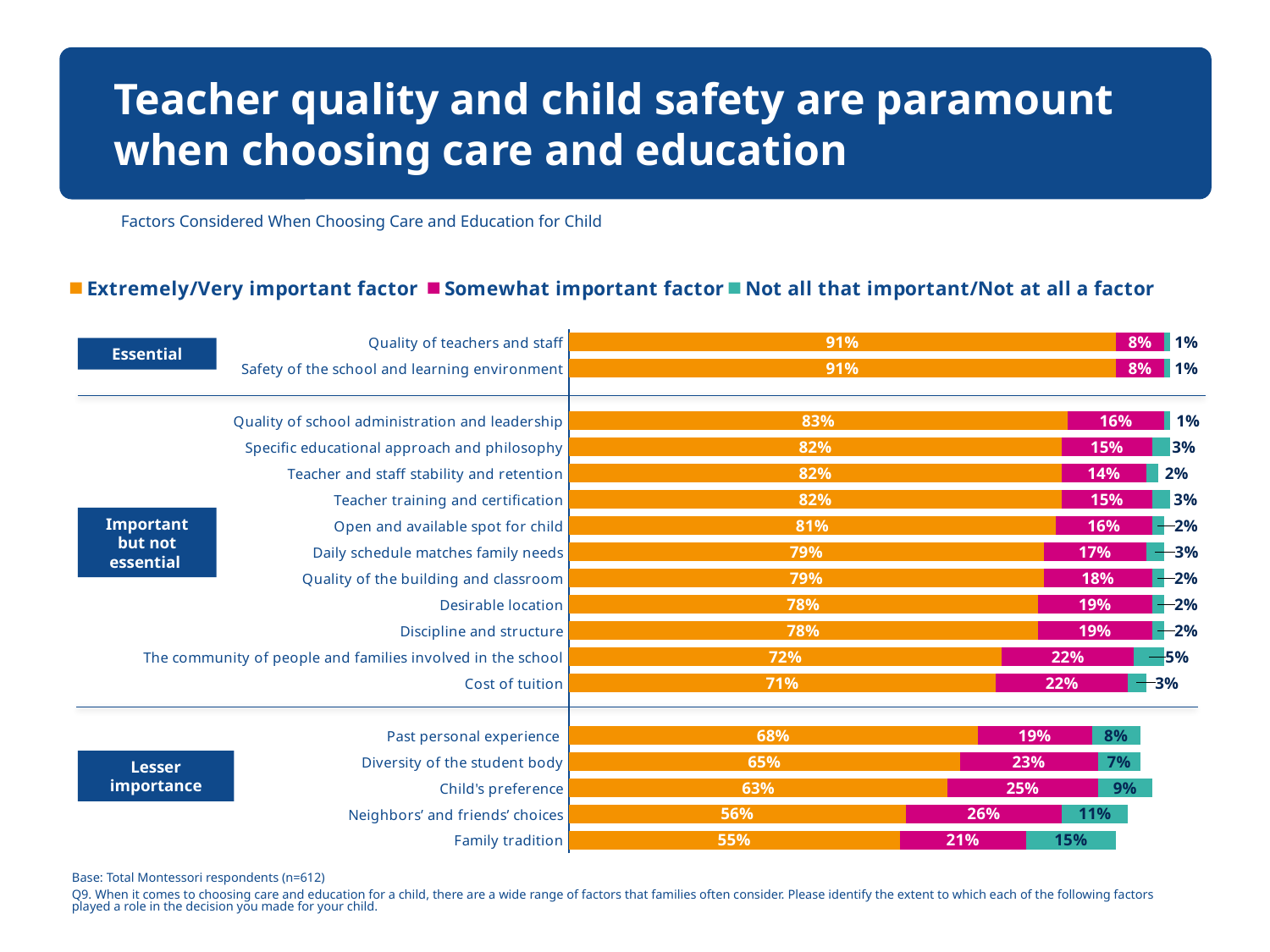
What is the Somewhat important factor value for Child's preference? 25% Which factor has the lowest Extremely/Very important factor percentage? Family tradition Which factor has the highest Somewhat important factor percentage? Neighbors' and friends' choices What is the Not all that important/Not at all a factor value for Family tradition? 15% What is the difference in Extremely/Very important factor percentage between Quality of teachers and staff and Family tradition? 36 percentage points What is the subtitle of the chart shown below the main heading? Factors Considered When Choosing Care and Education for Child What is the total of the three segments for the Past personal experience bar? 95% How many series does the legend list? 3 What percentage rated Cost of tuition as an Extremely/Very important factor? 71% What kind of chart is shown on the slide? Stacked bar chart How many factors (categories) are plotted in the chart? 18 Which has a higher Extremely/Very important factor percentage: Diversity of the student body or Neighbors' and friends' choices? Diversity of the student body